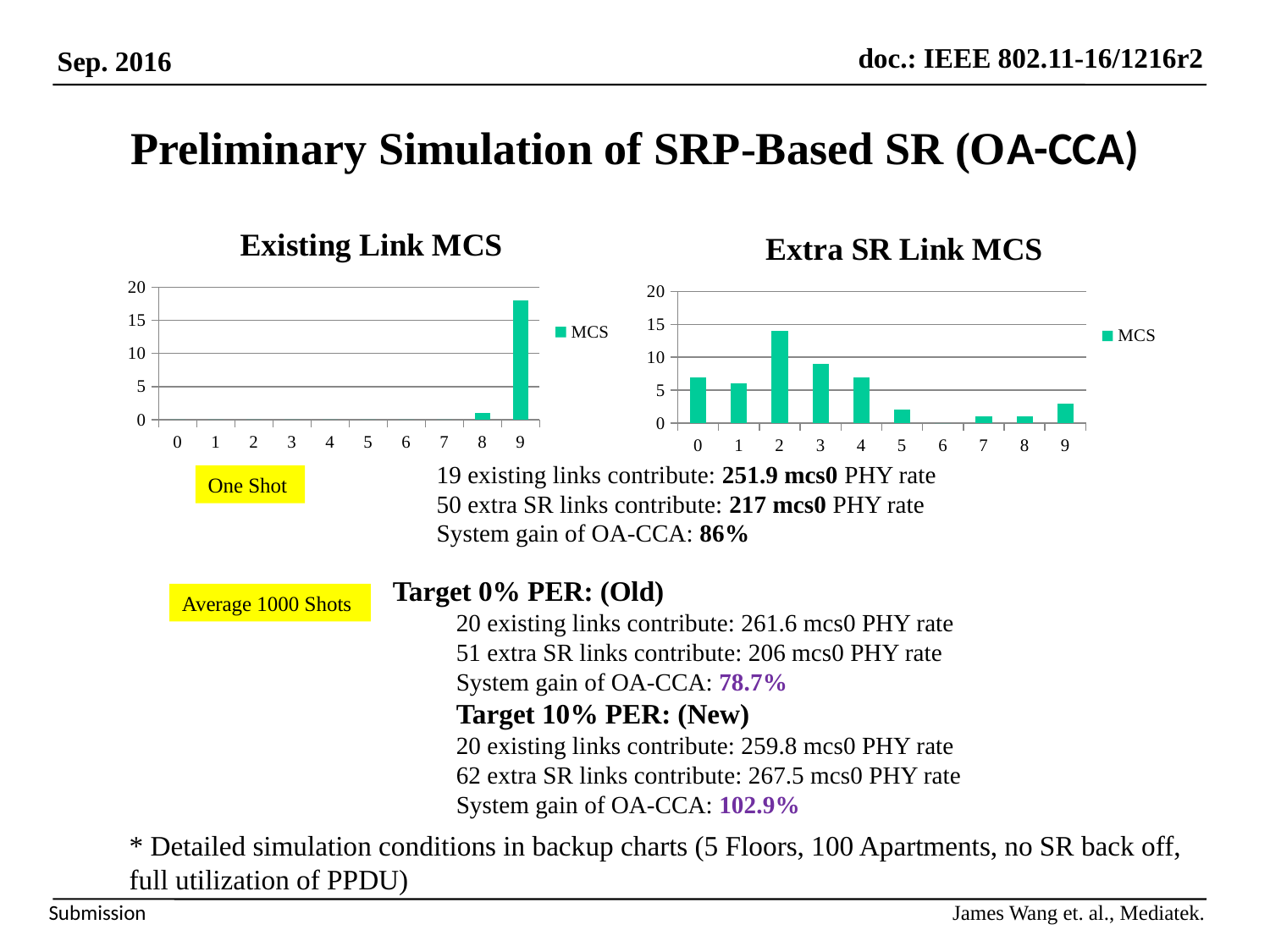
In the "Existing Link MCS" chart, is the value for MCS 9 greater or less than 15? greater In the "Extra SR Link MCS" chart, is the value for MCS 3 greater or less than 10? less In the "Extra SR Link MCS" chart, which MCS category has the highest value? 2 How many MCS categories are shown on the x axis of the "Existing Link MCS" chart? 10 What kind of chart is the "Existing Link MCS" chart? bar chart In the "Extra SR Link MCS" chart, is the value for MCS 2 greater or less than 10? greater How many series does the legend of the "Extra SR Link MCS" chart list? 1 What is the legend entry shown on the "Existing Link MCS" chart? MCS In the "Extra SR Link MCS" chart, which MCS category has the lowest value? 6 In the "Existing Link MCS" chart, which MCS category has the highest value? 9 In the "Extra SR Link MCS" chart, which has the larger value, MCS 1 or MCS 3? MCS 3